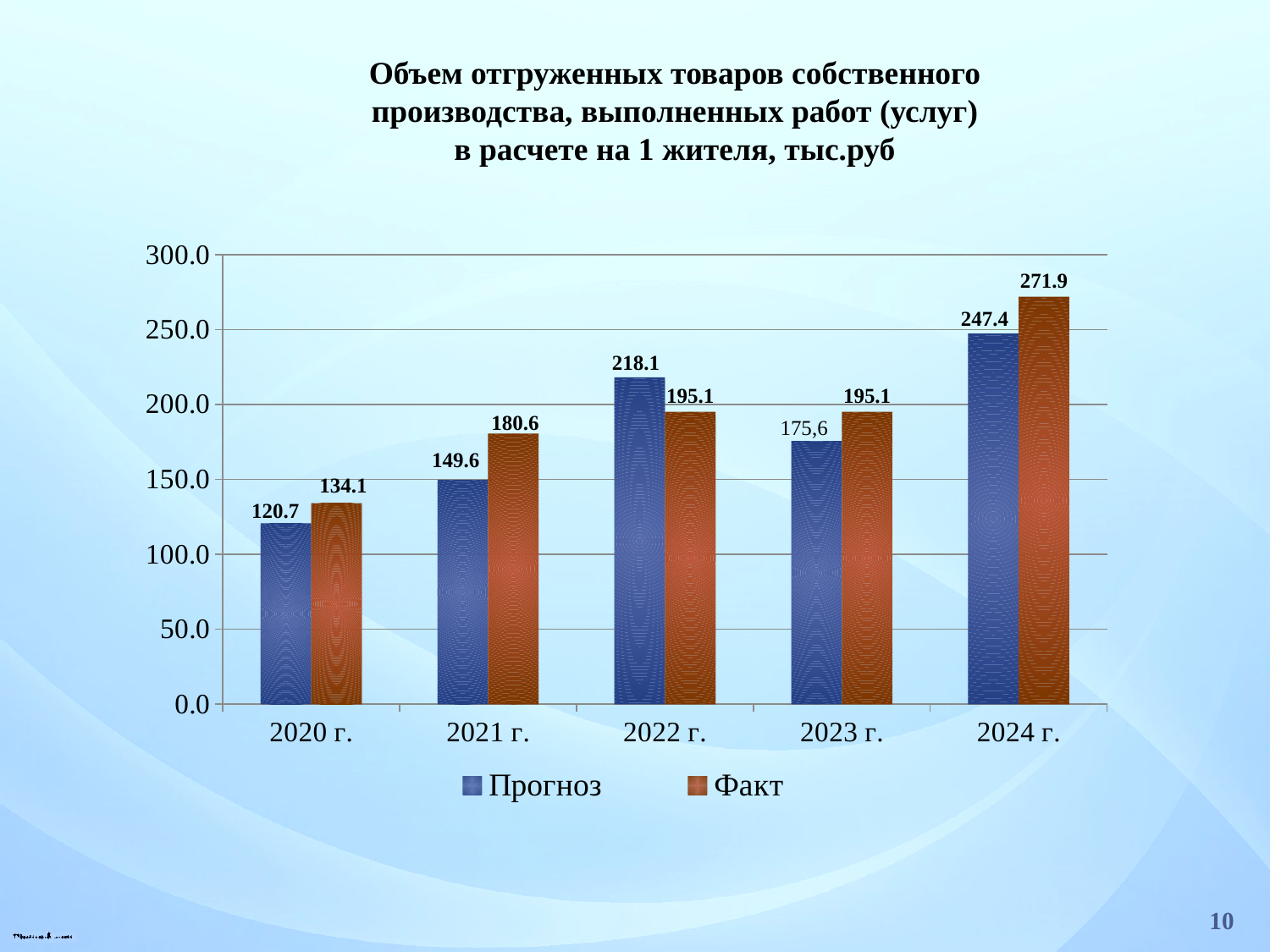
In which year is the Прогноз value lowest? 2020 г. What is the Прогноз value for 2023 г.? 175,6 How many years are shown on the x axis? 5 What is the Прогноз value for 2021 г.? 149.6 For 2022 г., which is larger: Прогноз or Факт? Прогноз What is the Факт value for 2022 г.? 195.1 Is the Прогноз value for 2024 г. greater or less than 200.0? greater How many series does the legend list? 2 What is the Факт value for 2024 г.? 271.9 In which year is the Факт value highest? 2024 г. What kind of chart is shown on the slide? bar chart What is the difference between the Факт and Прогноз values for 2021 г.? 31.0